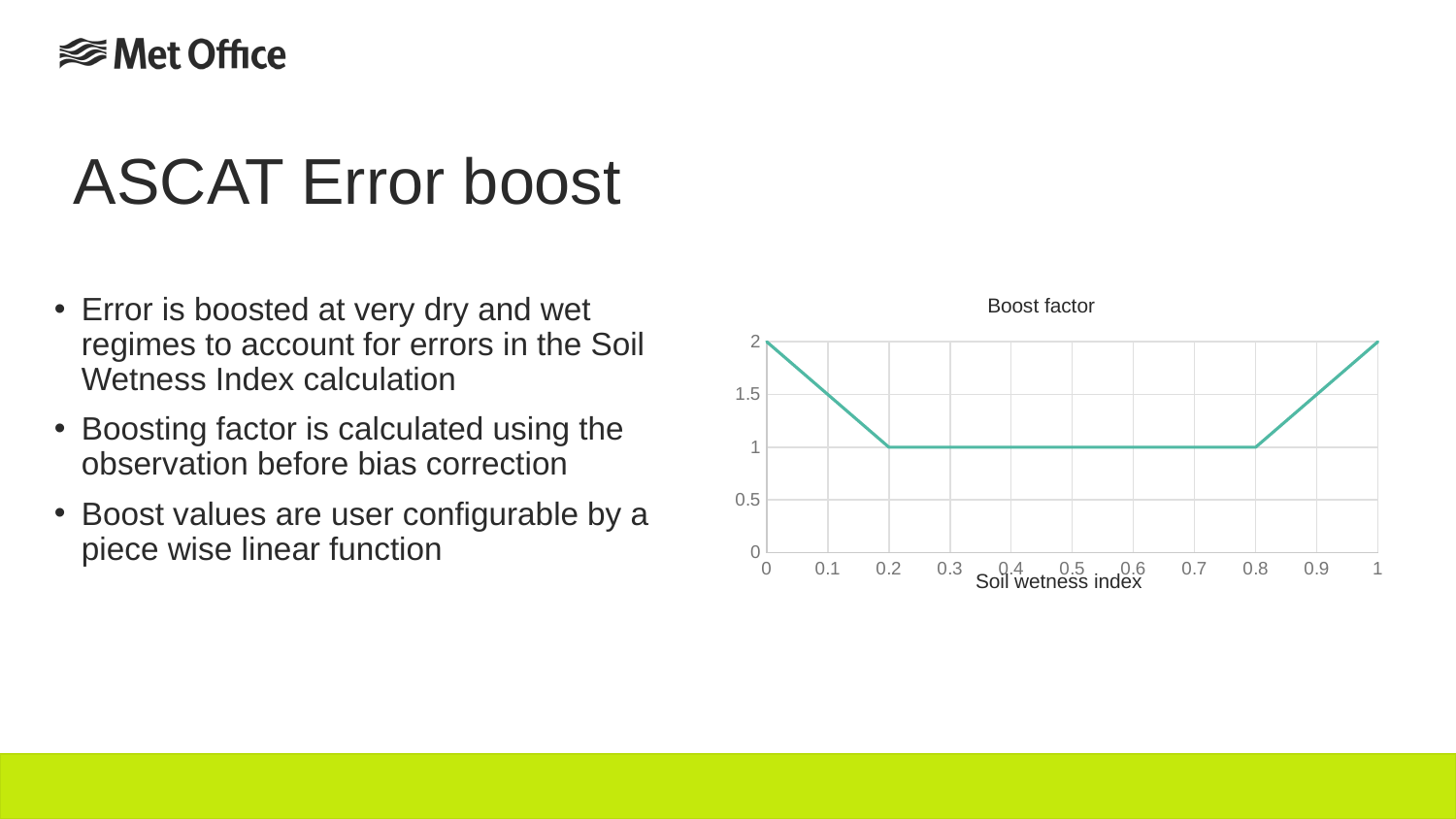
What is the boost factor at a soil wetness index of 0.2? 1 What is the boost factor at a soil wetness index of 0.8? 1 What is the boost factor at a soil wetness index of 1? 2 Does the boost factor rise or fall as the soil wetness index goes from 0.8 to 1? rise Is the boost factor at a soil wetness index of 0.5 greater or less than 1.5? less Which is larger, the boost factor at a soil wetness index of 0 or at 0.5? 0 What is the boost factor at a soil wetness index of 0? 2 Does the boost factor rise or fall as the soil wetness index goes from 0 to 0.2? fall What is the title of the chart? Boost factor What is the difference between the boost factor at a soil wetness index of 0 and at 0.2? 1 What is the label of the x axis of the chart? Soil wetness index What kind of chart is shown on the slide? line chart